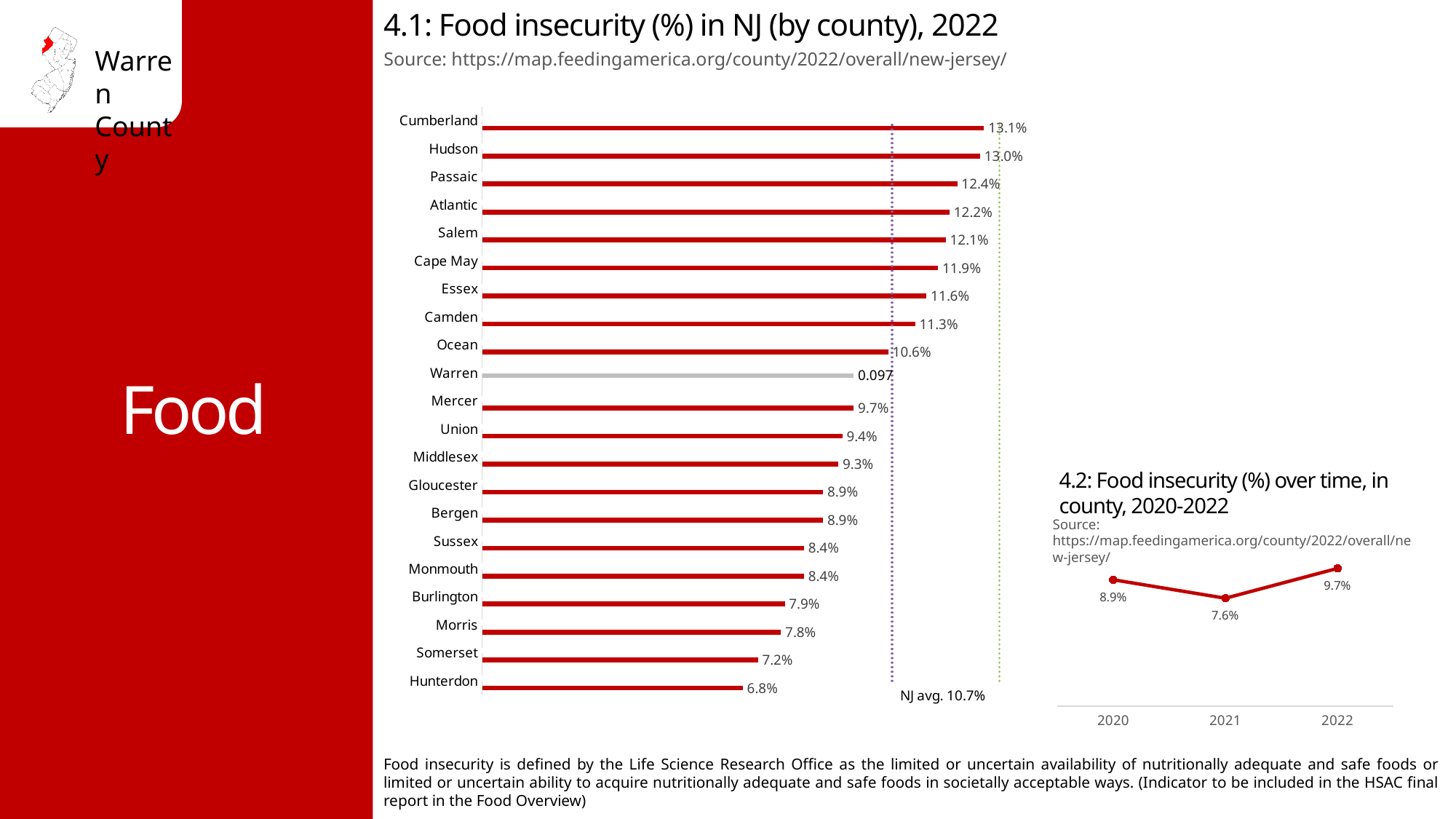
In chart 4.1, what is the food insecurity rate for Ocean? 10.6% In chart 4.1, what is the food insecurity rate for Passaic? 12.4% In chart 4.2, what is the food insecurity rate for 2021? 7.6% In chart 4.1, what is the difference between the food insecurity rates of Cumberland and Hunterdon? 6.3% How many counties are shown in chart 4.1? 21 In chart 4.2, what is the difference between the food insecurity rates for 2022 and 2021? 2.1% What kind of chart is 4.1: Food insecurity (%) in NJ (by county), 2022? bar chart In chart 4.1, what NJ average value is marked by the dotted reference line? 10.7% In chart 4.1, which county has the highest food insecurity rate? Cumberland In chart 4.1, which county has the lowest food insecurity rate? Hunterdon What kind of chart is 4.2: Food insecurity (%) over time, in county, 2020-2022? line chart In chart 4.1, which county has a higher food insecurity rate, Essex or Camden? Essex